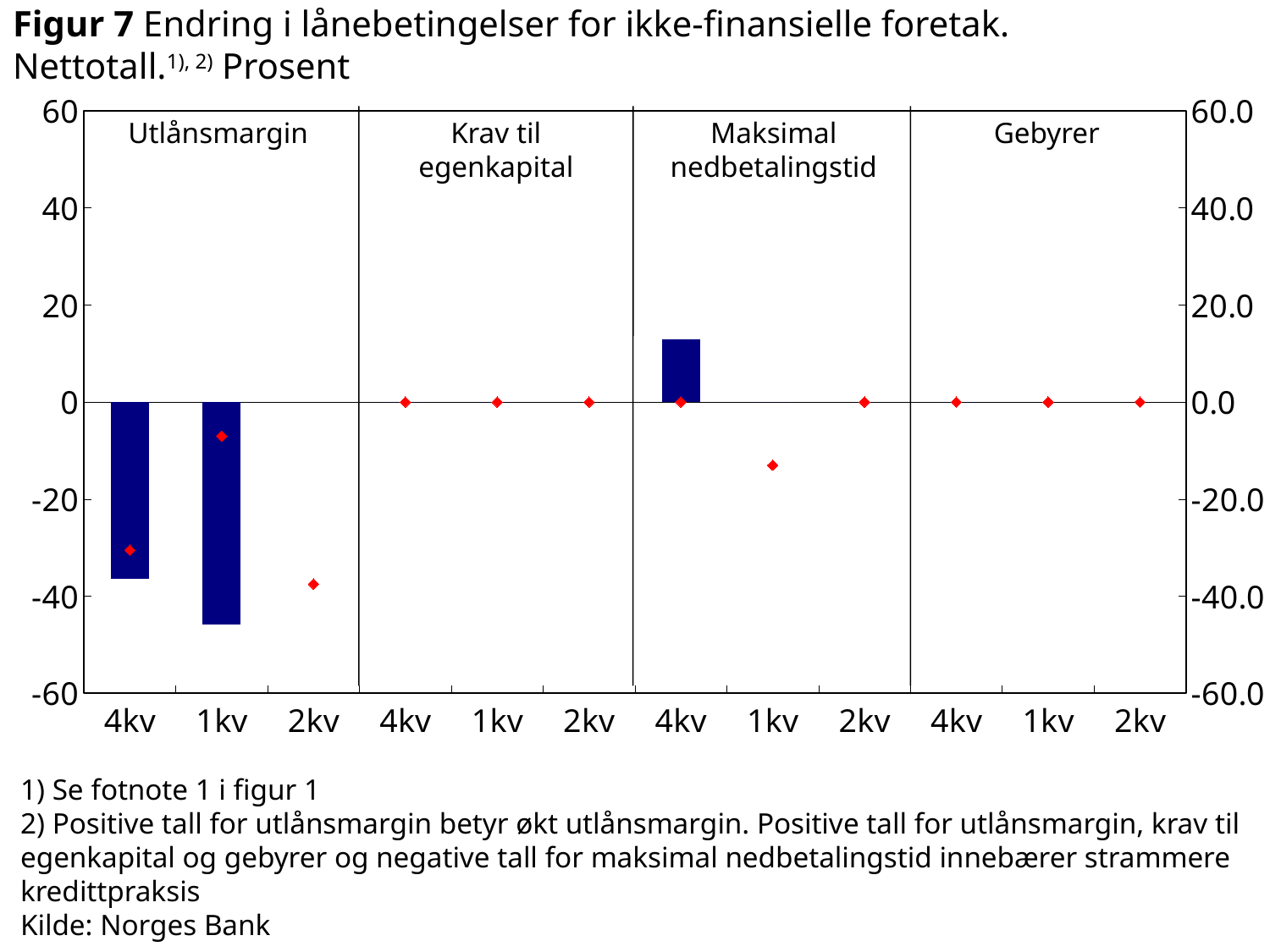
Is the bar for 4kv in the Maksimal nedbetalingstid panel greater or less than 0? greater How many panels (loan condition categories) does the chart have? 4 Which panel contains the only bar with a positive value? Maksimal nedbetalingstid Is the bar for 1kv in the Utlånsmargin panel greater or less than -40? less Is the bar for 4kv in the Maksimal nedbetalingstid panel greater or less than 20? less What is the value of the red marker for 2kv in the Gebyrer panel? 0 What is the value of the red marker for 1kv in the Krav til egenkapital panel? 0 Which of the two bars in the Utlånsmargin panel, 4kv or 1kv, is lower? 1kv How many quarter labels are shown along the x axis in total? 12 What kind of chart is shown in Figur 7? bar chart